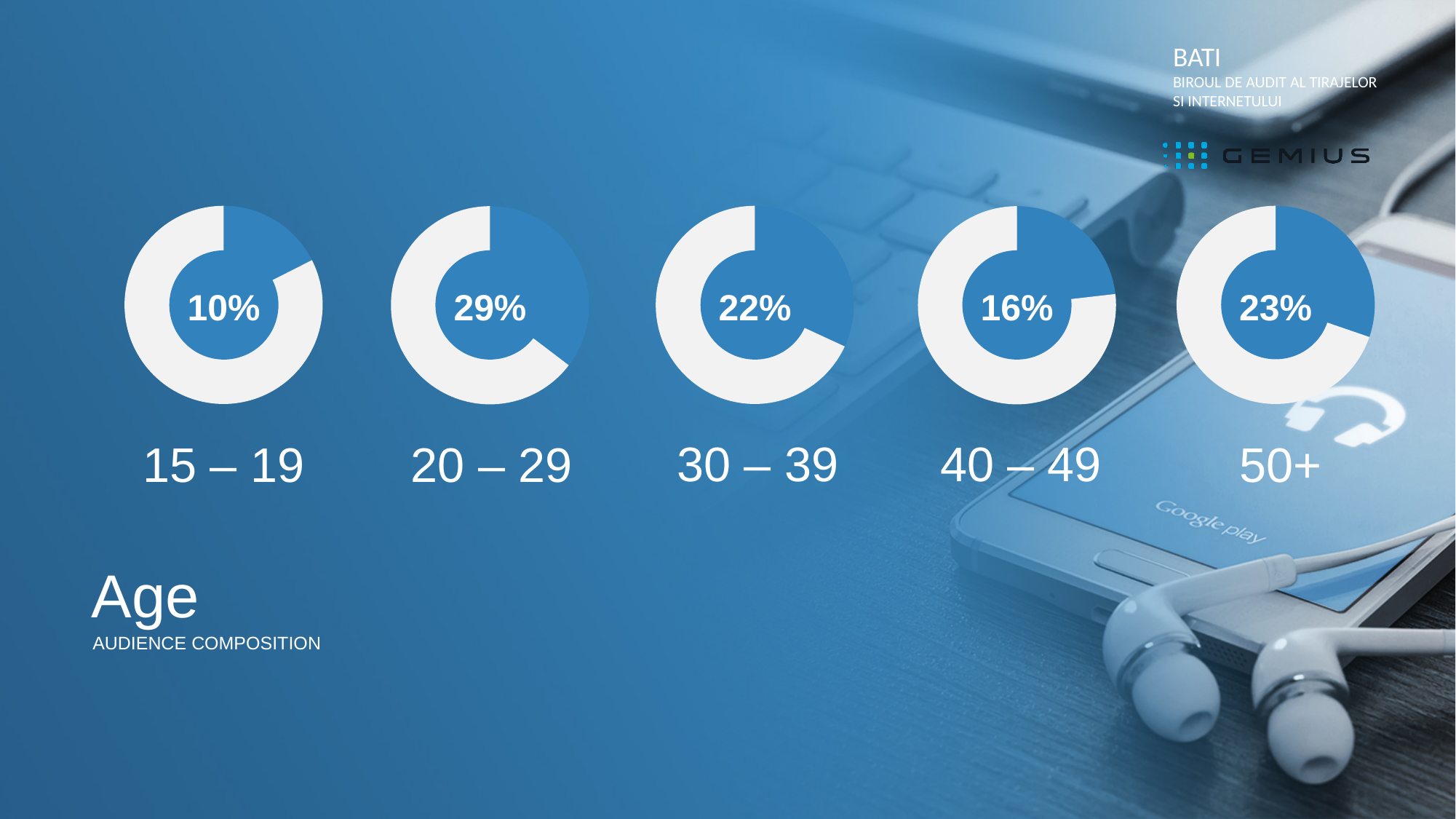
What share of the audience is in the 40 – 49 age group? 16% What share of the audience is in the 15 – 19 age group? 10% What share of the audience is in the 50+ age group? 23% Which age group has the smallest share of the audience? 15 – 19 What share of the audience is in the 20 – 29 age group? 29% What share of the audience is in the 30 – 39 age group? 22% What is the title of the slide's chart section? Age How many age groups are shown on the slide? 5 Which age group has the largest share of the audience? 20 – 29 Which age group has a larger share: 30 – 39 or 50+? 50+ What is the difference in percentage points between the 20 – 29 and 15 – 19 age groups? 19 What kind of chart is used to show each age group's share? Donut chart